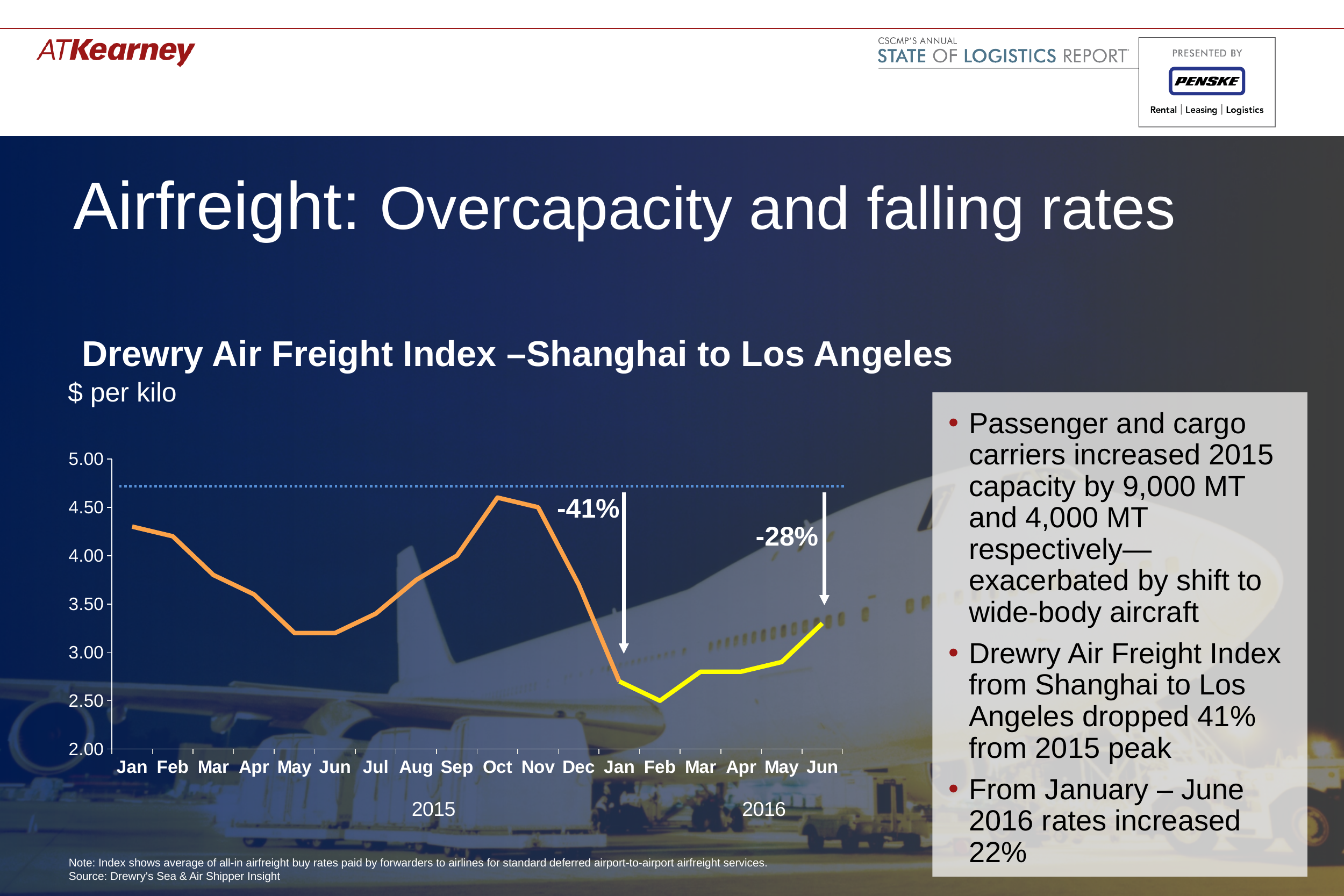
Does the index rise or fall from Feb 2016 to Jun 2016? rise How many monthly data points are plotted on the chart? 18 In which month does the index reach its lowest value? Feb 2016 Is the value for Jun 2016 greater or less than 3.00? greater Is the value for Jan 2015 greater or less than 4.00? greater Is the value for May 2015 greater or less than 3.50? less What kind of chart is shown on the slide? line chart What is the title of the chart? Drewry Air Freight Index –Shanghai to Los Angeles What unit is the y axis of the chart measured in? $ per kilo Which is larger, the value for Oct 2015 or the value for Jan 2016? Oct 2015 In which month does the index reach its highest value? Oct 2015